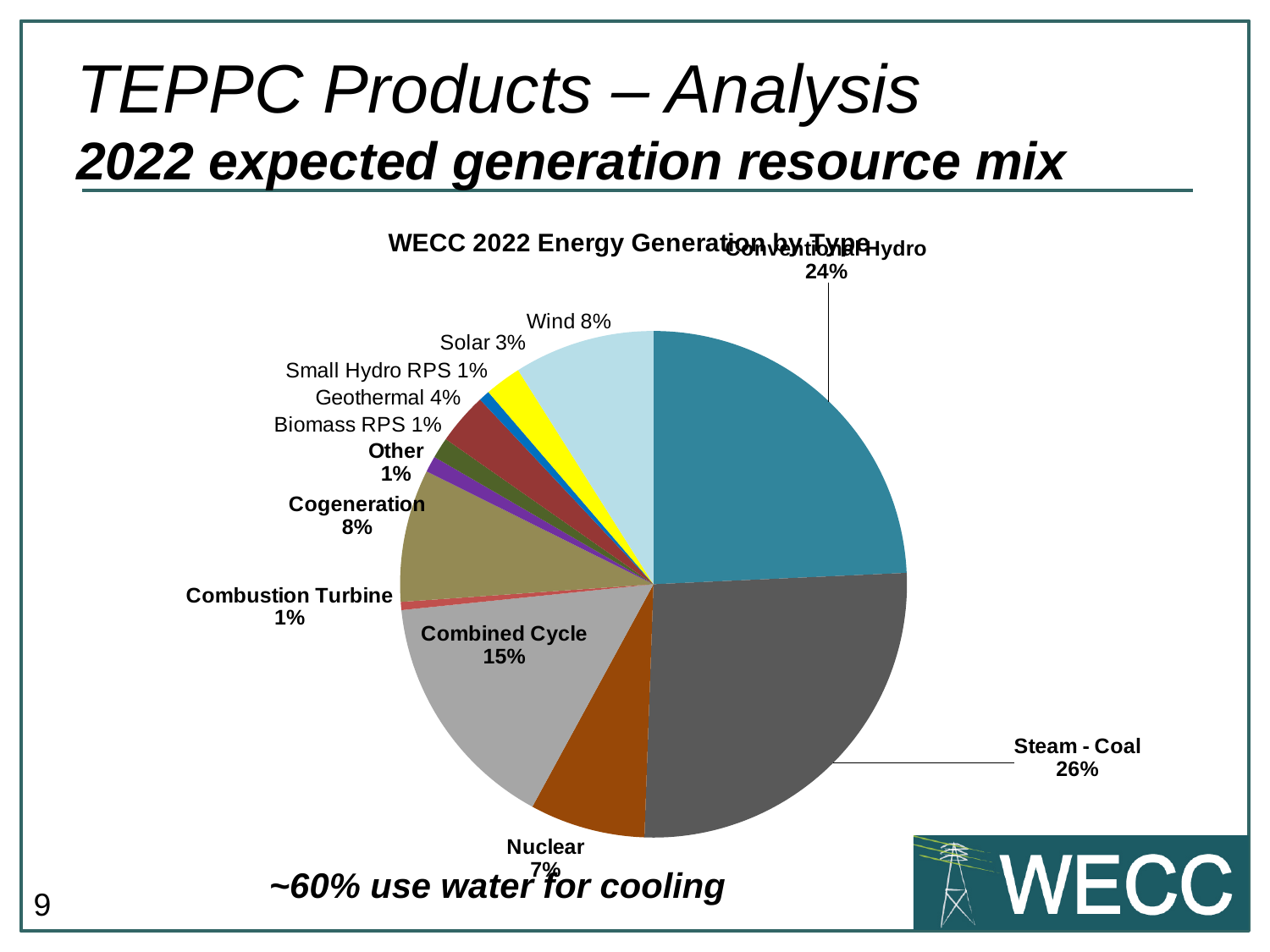
What is the title of the chart? WECC 2022 Energy Generation by Type Which generation type has the largest slice of the pie? Steam - Coal How many generation types (slices) are shown in the pie chart? 12 Which is larger, Conventional Hydro or Steam - Coal? Steam - Coal What share is shown for Solar? 3% What is the value for Combined Cycle? 15% What type of chart is shown on the slide? Pie chart What percentage does Nuclear contribute? 7% What is the difference in percentage points between Steam - Coal and Conventional Hydro? 2 percentage points What share of generation does Steam - Coal account for? 26% What percentage is shown for Conventional Hydro? 24% What is the value shown for Geothermal? 4%